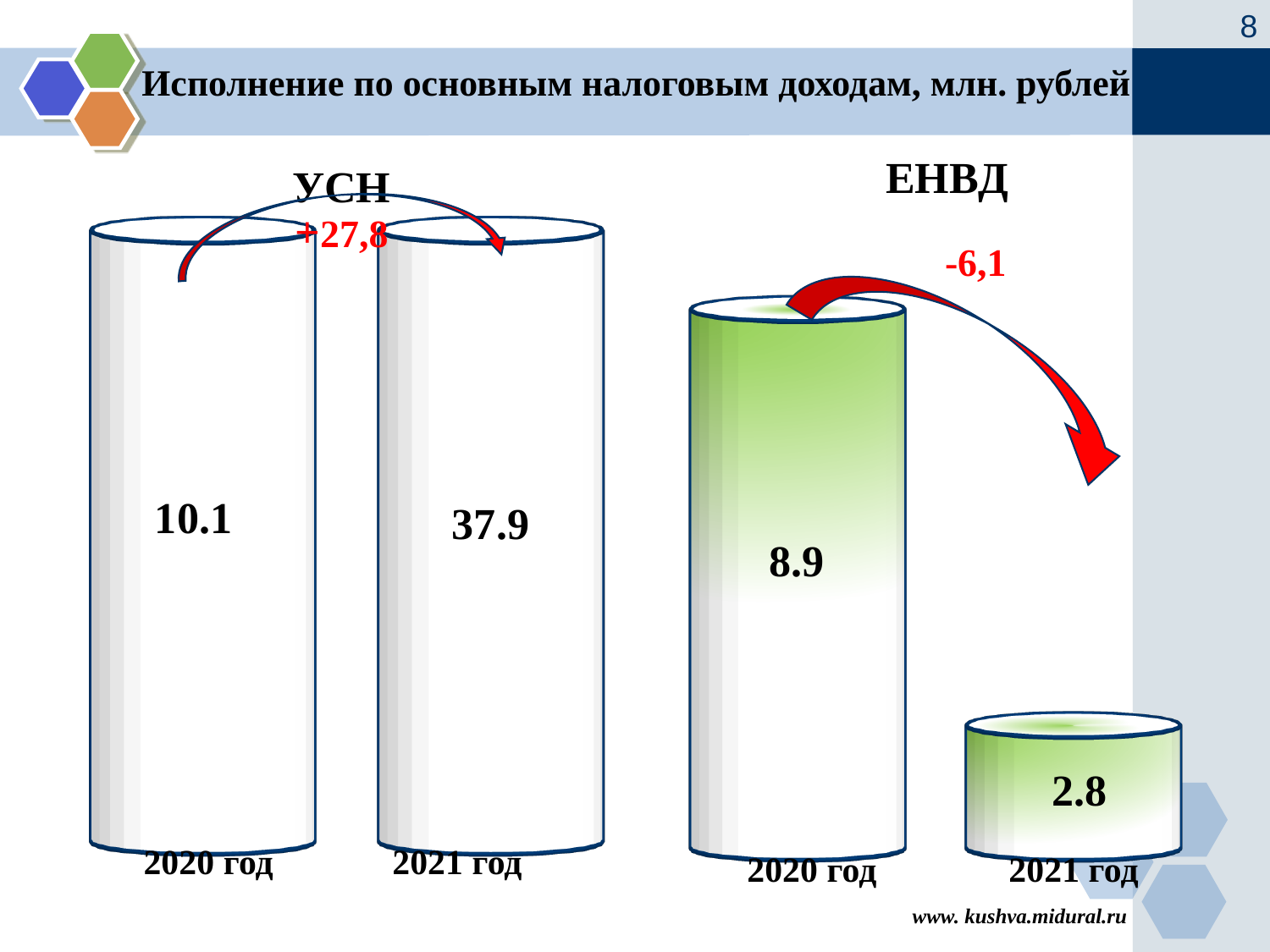
How many categories are shown in the ЕНВД chart? 2 What kind of chart is the ЕНВД chart? bar chart In the УСН chart, what is the difference between the 2021 год and 2020 год values? 27.8 In the ЕНВД chart, what is the difference between the 2020 год and 2021 год values? 6.1 In the ЕНВД chart, which year has the lowest value? 2021 год In the УСН chart, what is the value for 2020 год? 10.1 In the УСН chart, which year has the highest value? 2021 год In the ЕНВД chart, what is the value for 2021 год? 2.8 In the ЕНВД chart, do the values rise or fall from 2020 год to 2021 год? fall In the ЕНВД chart, which is larger, the value for 2020 год or 2021 год? 2020 год In the УСН chart, what is the value for 2021 год? 37.9 In the ЕНВД chart, what is the value for 2020 год? 8.9